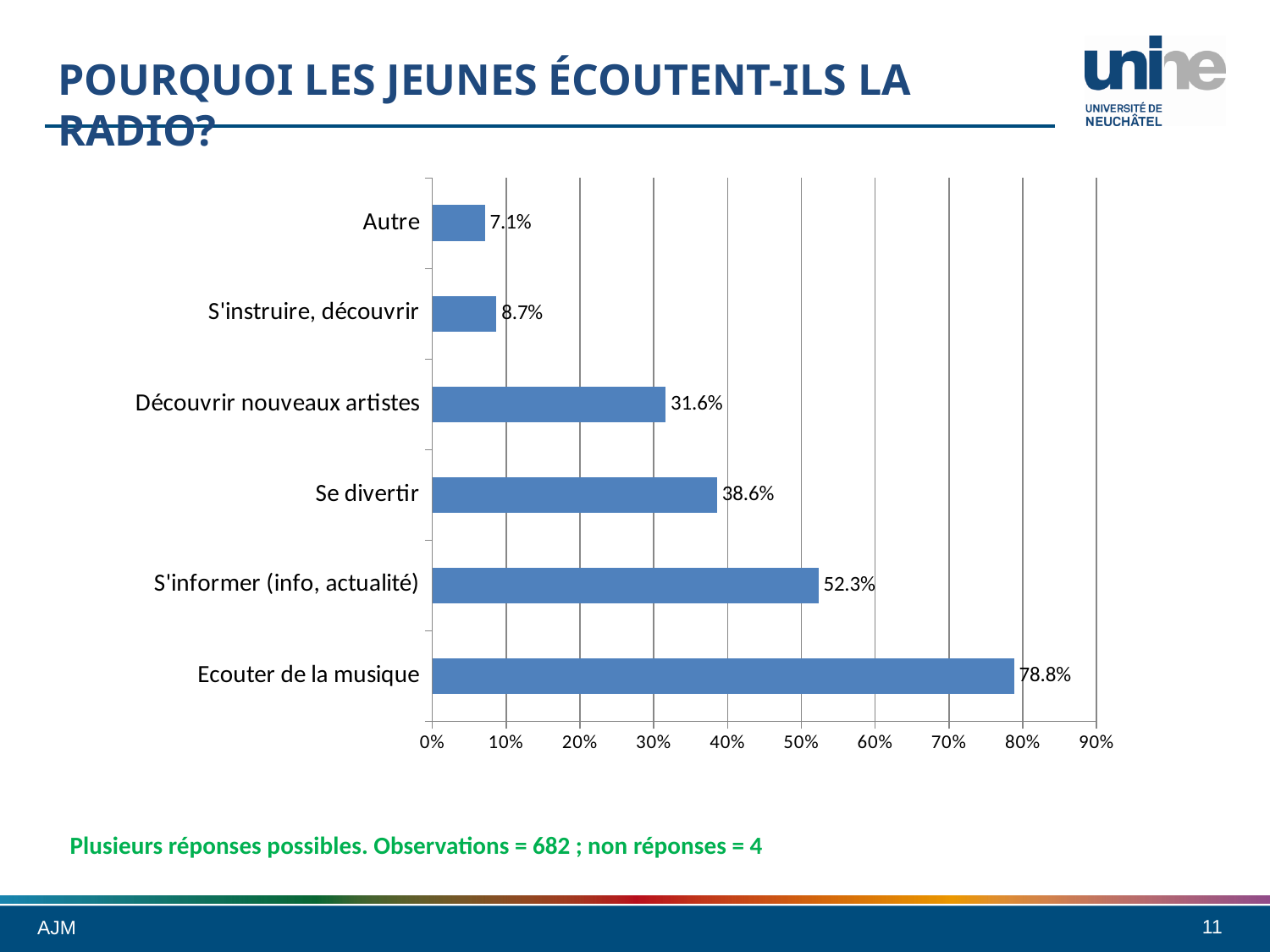
How many categories are shown in the chart? 6 Is the value for "S'instruire, découvrir" greater or less than 10%? less What is the value for "Se divertir"? 38.6% Which category has the highest value? Ecouter de la musique Which is larger, the value for "Se divertir" or the value for "Découvrir nouveaux artistes"? Se divertir What is the value for "Découvrir nouveaux artistes"? 31.6% What is the value for "Autre"? 7.1% Which category has the lowest value? Autre What is the value for "Ecouter de la musique"? 78.8% What kind of chart is shown on the slide? bar chart What is the value for "S'informer (info, actualité)"? 52.3% What is the difference between the values for "Ecouter de la musique" and "S'informer (info, actualité)"? 26.5%